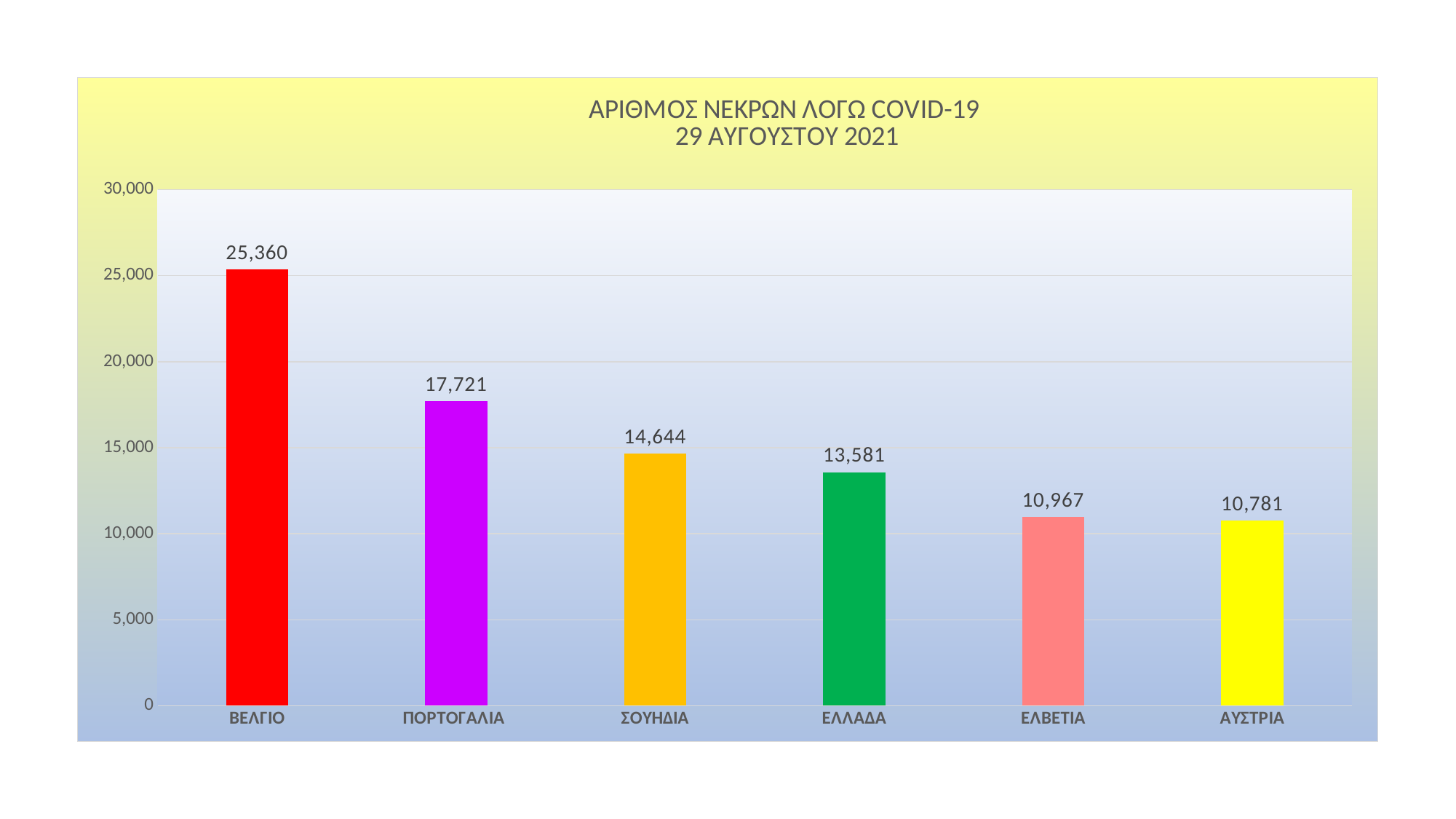
Is the value for ΕΛΒΕΤΙΑ greater or less than 15,000? less What is the value for ΕΛΛΑΔΑ? 13,581 Which is larger, the value for ΠΟΡΤΟΓΑΛΙΑ or the value for ΣΟΥΗΔΙΑ? ΠΟΡΤΟΓΑΛΙΑ What is the difference between the values for ΒΕΛΓΙΟ and ΠΟΡΤΟΓΑΛΙΑ? 7,639 What is the title of the chart? ΑΡΙΘΜΟΣ ΝΕΚΡΩΝ ΛΟΓΩ COVID-19 29 ΑΥΓΟΥΣΤΟΥ 2021 Which country has the lowest number of deaths? ΑΥΣΤΡΙΑ How many countries are shown on the chart? 6 What is the value for ΑΥΣΤΡΙΑ? 10,781 What kind of chart is shown on the slide? bar chart What is the difference between the values for ΣΟΥΗΔΙΑ and ΕΛΛΑΔΑ? 1,063 What is the value for ΒΕΛΓΙΟ? 25,360 Which country has the highest number of deaths? ΒΕΛΓΙΟ